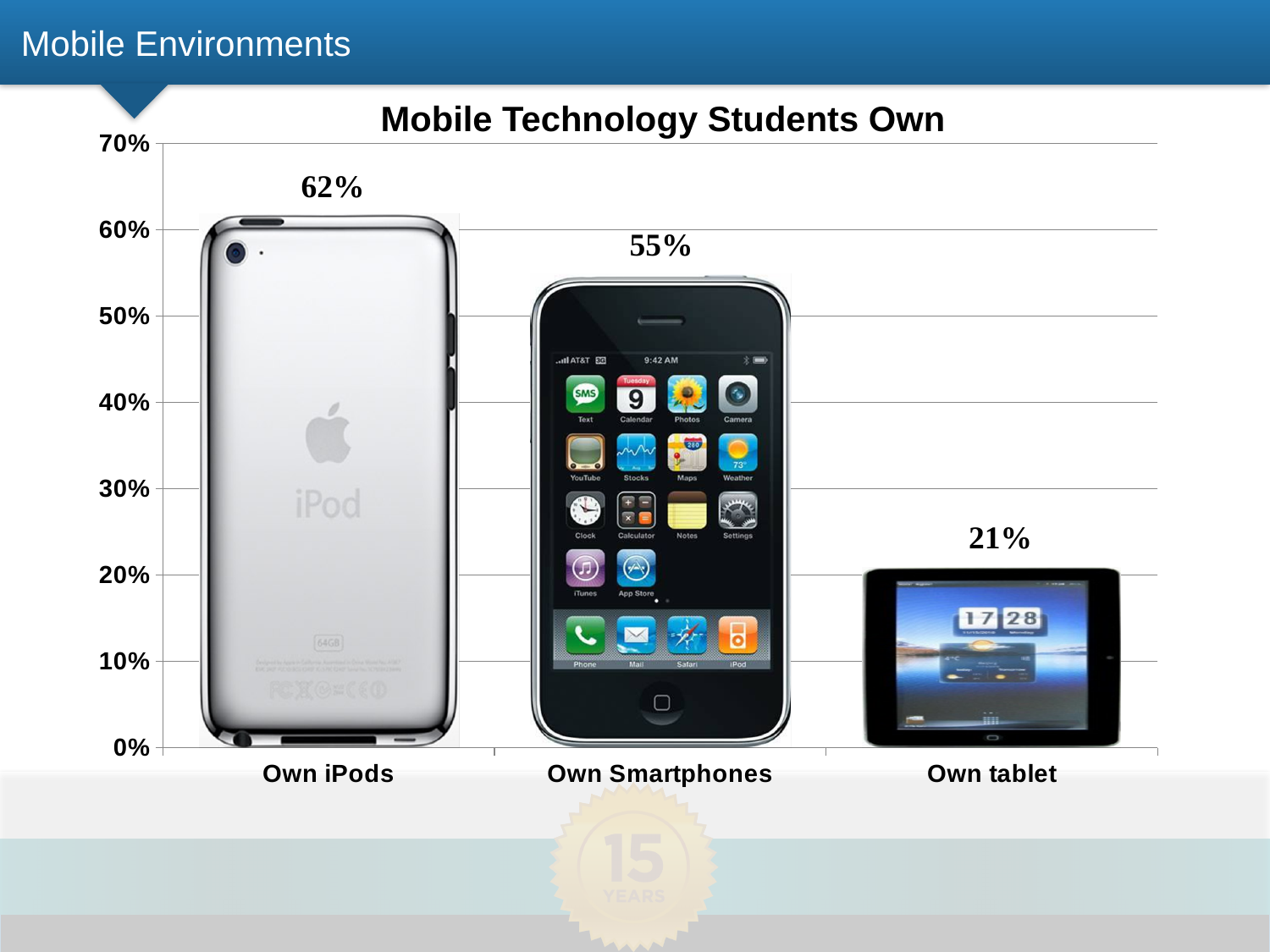
What percentage of students own a tablet? 21% What percentage of students own smartphones? 55% Which category has the lowest value? Own tablet What is the title of the chart? Mobile Technology Students Own What percentage of students own iPods? 62% Which category has the highest value? Own iPods What is the difference between the percentage who own iPods and the percentage who own smartphones? 7% How many categories are shown on the chart? 3 Is the value for Own tablet greater or less than 30%? less What is the difference between the percentage who own smartphones and the percentage who own a tablet? 34% Which is larger: the value for Own Smartphones or the value for Own tablet? Own Smartphones What kind of chart is this? bar chart